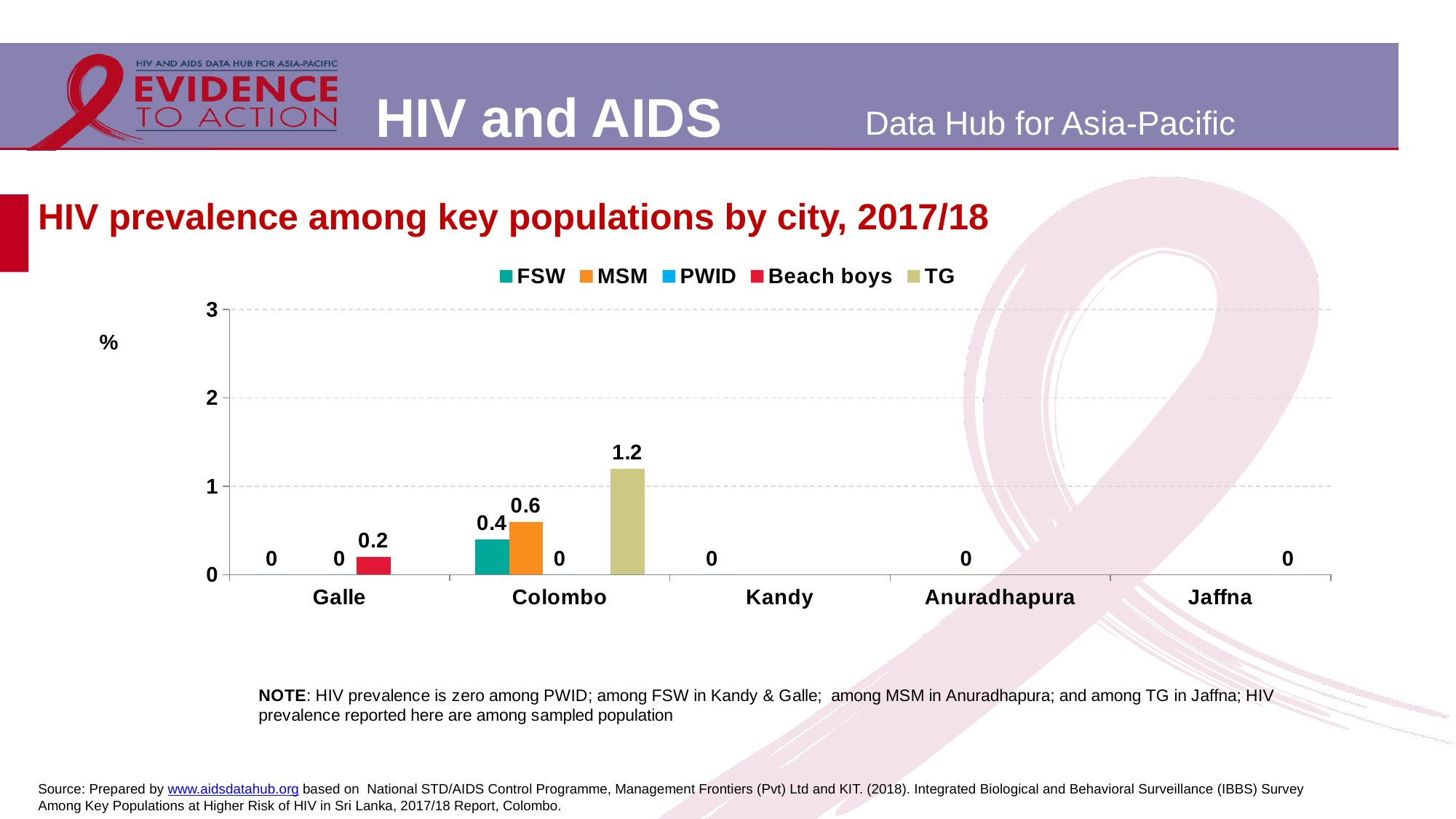
What is the HIV prevalence among Beach boys in Galle? 0.2 What is the difference between the HIV prevalence among TG and among MSM in Colombo? 0.6 How many cities are shown on the x axis of the chart? 5 Which key population has the highest HIV prevalence in Colombo? TG Which city has the highest HIV prevalence value shown on the chart? Colombo What kind of chart is used to show HIV prevalence among key populations by city? Bar chart In Colombo, which has a higher HIV prevalence: MSM or FSW? MSM Is the HIV prevalence among TG in Colombo greater or less than 1? greater What is the HIV prevalence among FSW in Colombo? 0.4 How many key populations does the legend list? 5 What is the HIV prevalence among MSM in Colombo? 0.6 What is the HIV prevalence among TG in Colombo? 1.2